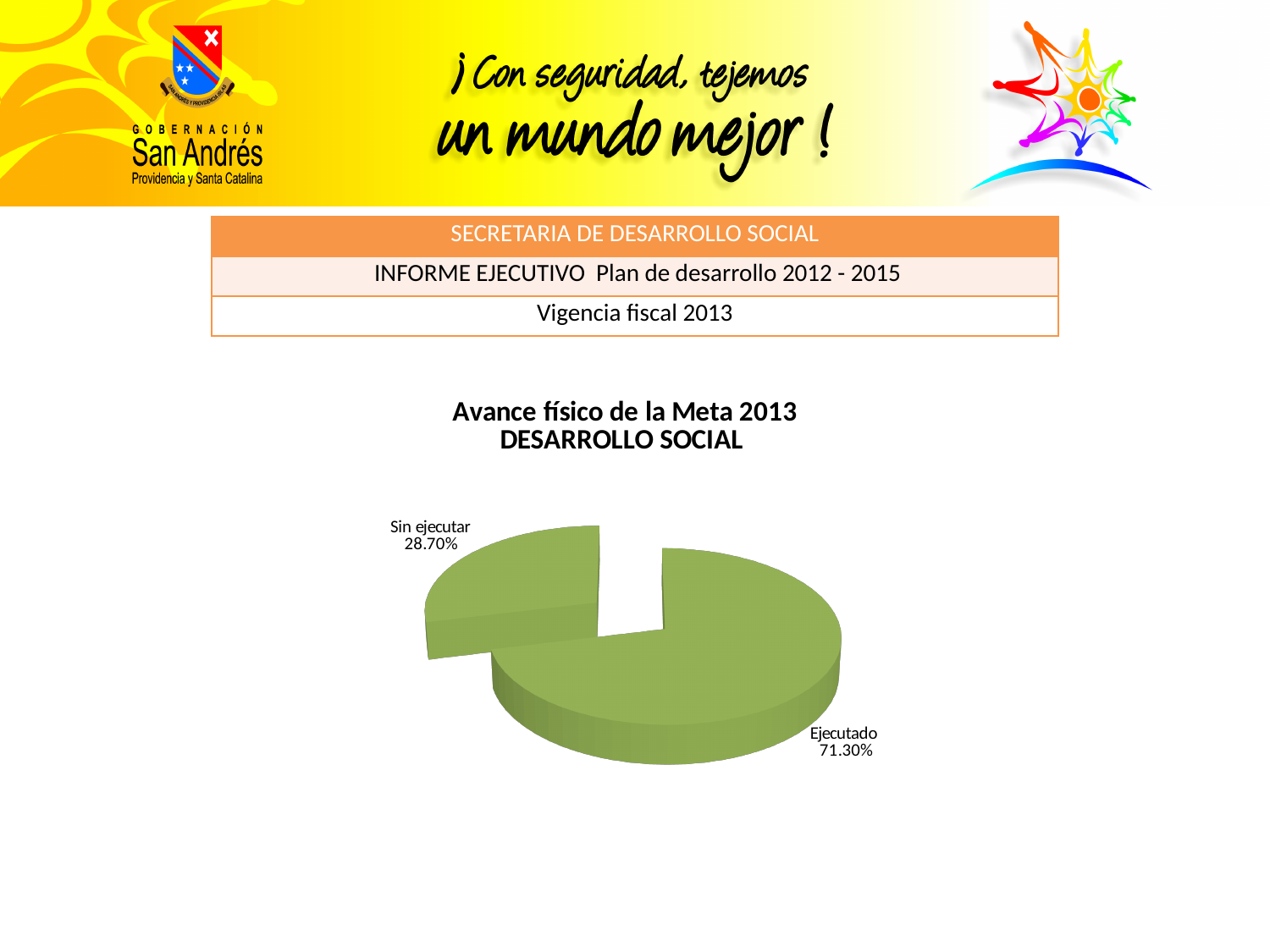
Which is larger, the Ejecutado slice or the Sin ejecutar slice? Ejecutado What colour are the slices of the pie chart? Green What kind of chart is shown on the slide? Pie chart What is the title of the chart? Avance físico de la Meta 2013 DESARROLLO SOCIAL Which slice of the pie chart is the largest? Ejecutado How many slices does the pie chart have? 2 Which slice of the pie chart is the smallest? Sin ejecutar What percentage of the pie chart is labelled Sin ejecutar? 28.70% What is the difference in percentage points between the Ejecutado and Sin ejecutar slices? 42.60% What share of the pie does the Sin ejecutar slice represent? 28.70% What percentage of the pie chart is labelled Ejecutado? 71.30%